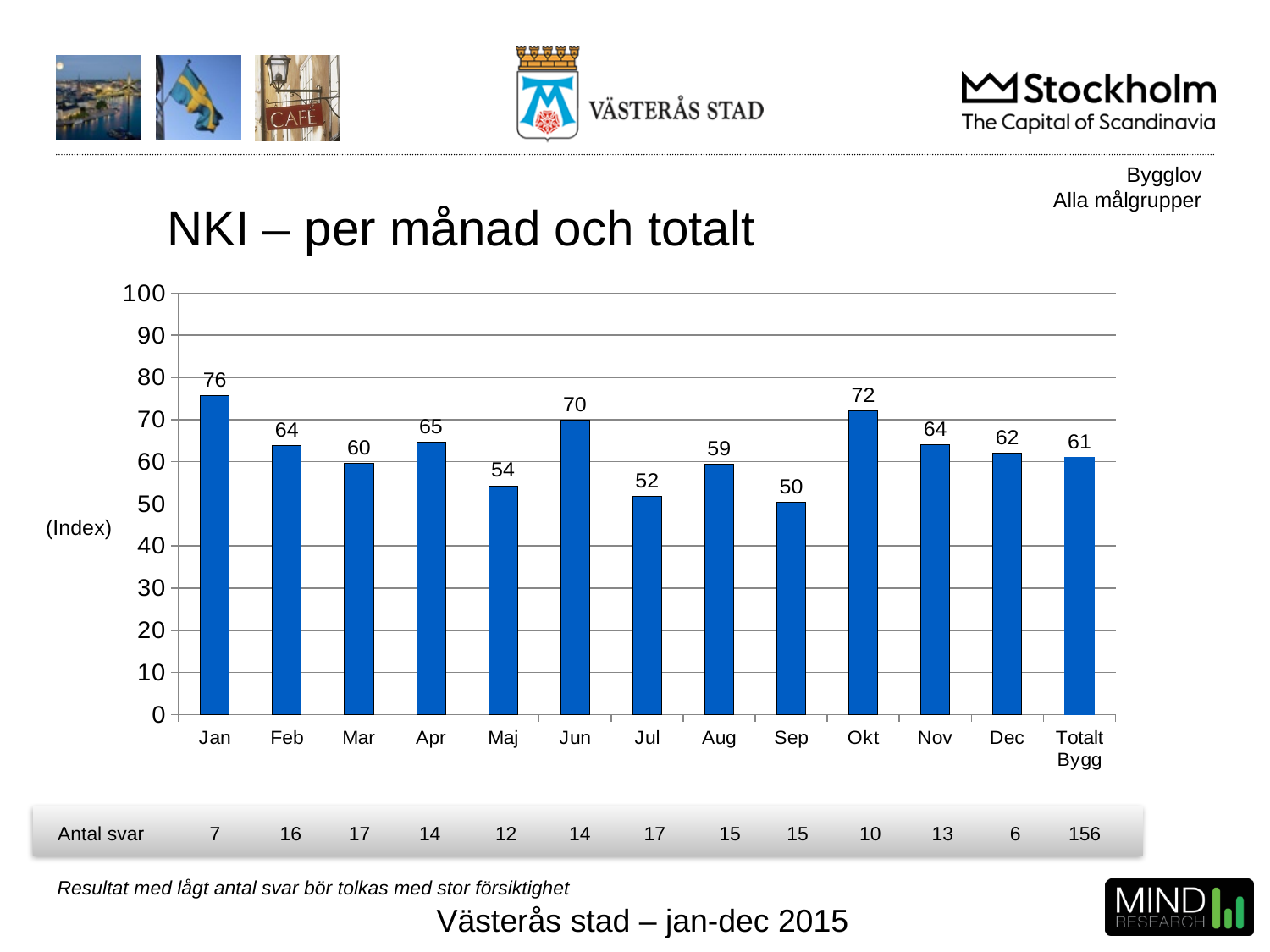
Which month has the lowest NKI value? Sep Which month has the highest NKI value? Jan How many categories are shown on the x axis of the chart? 13 What is the NKI value for Totalt Bygg? 61 What kind of chart is shown on the slide? bar chart What is the NKI value for Jan? 76 Which has a higher NKI value, Jun or Okt? Okt What is the title of the chart? NKI – per månad och totalt Do the NKI values rise or fall from Jun to Sep? fall What is the NKI value for Sep? 50 What is the difference between the NKI values for Jan and Sep? 26 Is the NKI value for Maj greater or less than 60? less